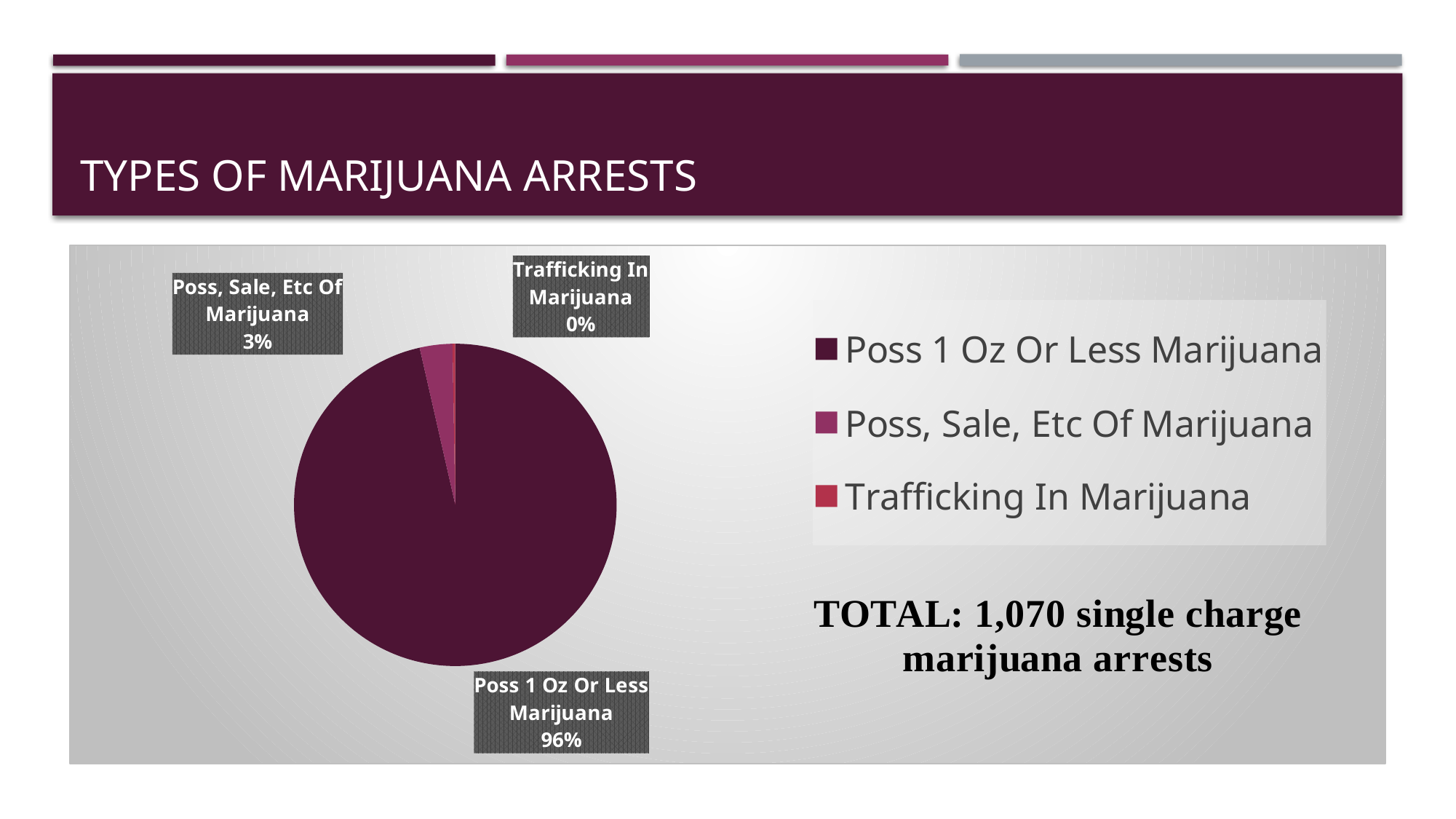
How many entries does the legend list? 3 What kind of chart is shown on the slide? pie chart Which is larger, the share for Poss, Sale, Etc Of Marijuana or the share for Trafficking In Marijuana? Poss, Sale, Etc Of Marijuana What is the difference in percentage points between the Poss 1 Oz Or Less Marijuana share and the Poss, Sale, Etc Of Marijuana share? 93% What share of the pie does Poss, Sale, Etc Of Marijuana represent? 3% According to the text beside the chart, what is the total number of single charge marijuana arrests? 1,070 Which category has the smallest slice of the pie? Trafficking In Marijuana What is the title of the slide containing the chart? Types of Marijuana Arrests How many categories does the pie chart show? 3 What share of the pie does Trafficking In Marijuana represent? 0% Which category has the largest slice of the pie? Poss 1 Oz Or Less Marijuana What share of the pie does Poss 1 Oz Or Less Marijuana represent? 96%